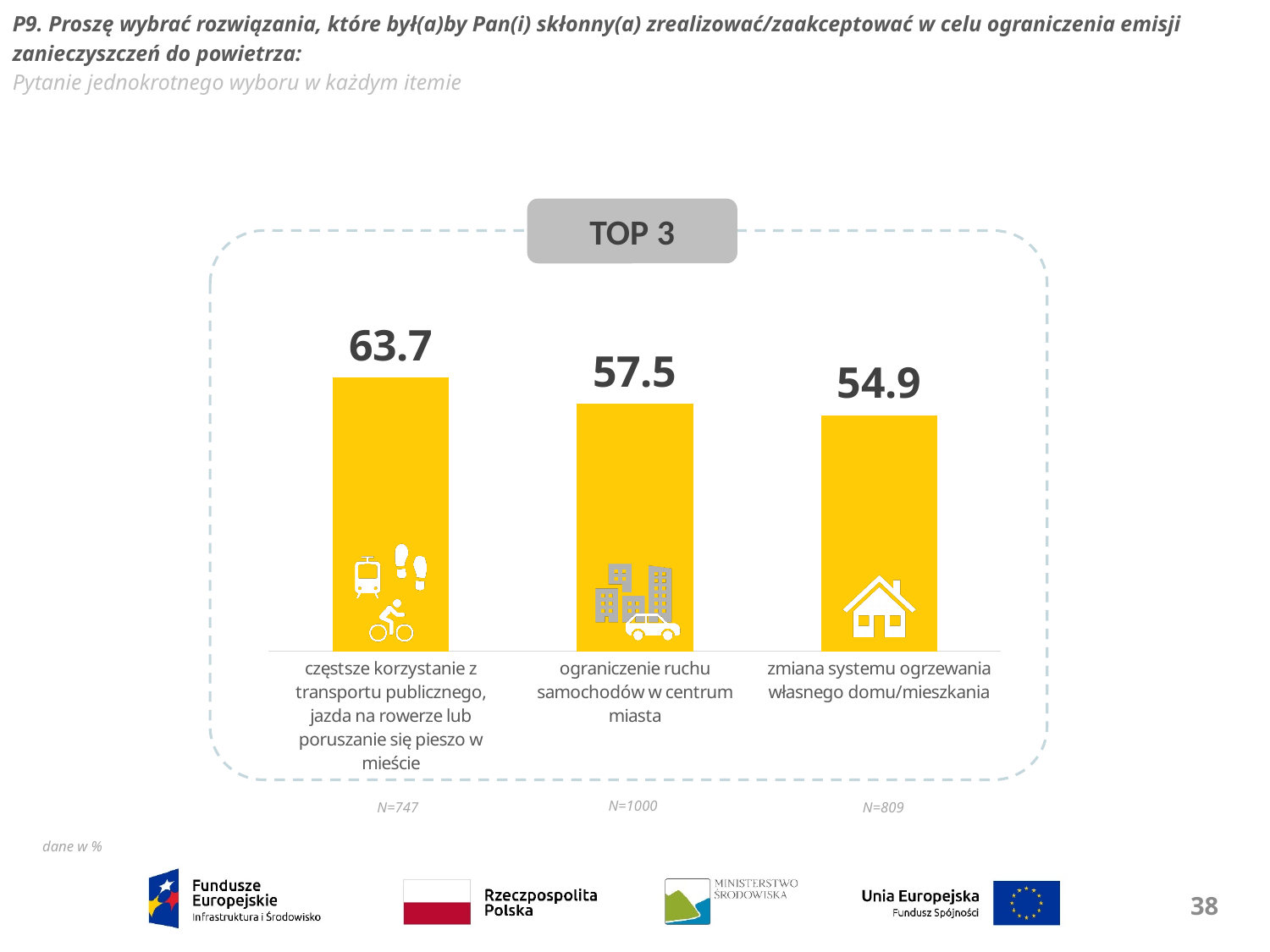
What is the difference between the values for "ograniczenie ruchu samochodów w centrum miasta" and "zmiana systemu ogrzewania własnego domu/mieszkania"? 2.6 How many categories are shown in the chart? 3 What is the value for "częstsze korzystanie z transportu publicznego, jazda na rowerze lub poruszanie się pieszo w mieście"? 63.7 Which is larger: the value for "ograniczenie ruchu samochodów w centrum miasta" or for "zmiana systemu ogrzewania własnego domu/mieszkania"? ograniczenie ruchu samochodów w centrum miasta What kind of chart is shown on the slide? bar chart Do the values rise or fall from left to right across the categories? fall What is the difference between the values for "częstsze korzystanie z transportu publicznego..." and "ograniczenie ruchu samochodów w centrum miasta"? 6.2 What is the label in the grey box above the chart? TOP 3 What is the value for "ograniczenie ruchu samochodów w centrum miasta"? 57.5 Which category has the highest value? częstsze korzystanie z transportu publicznego, jazda na rowerze lub poruszanie się pieszo w mieście What is the value for "zmiana systemu ogrzewania własnego domu/mieszkania"? 54.9 Which category has the lowest value? zmiana systemu ogrzewania własnego domu/mieszkania